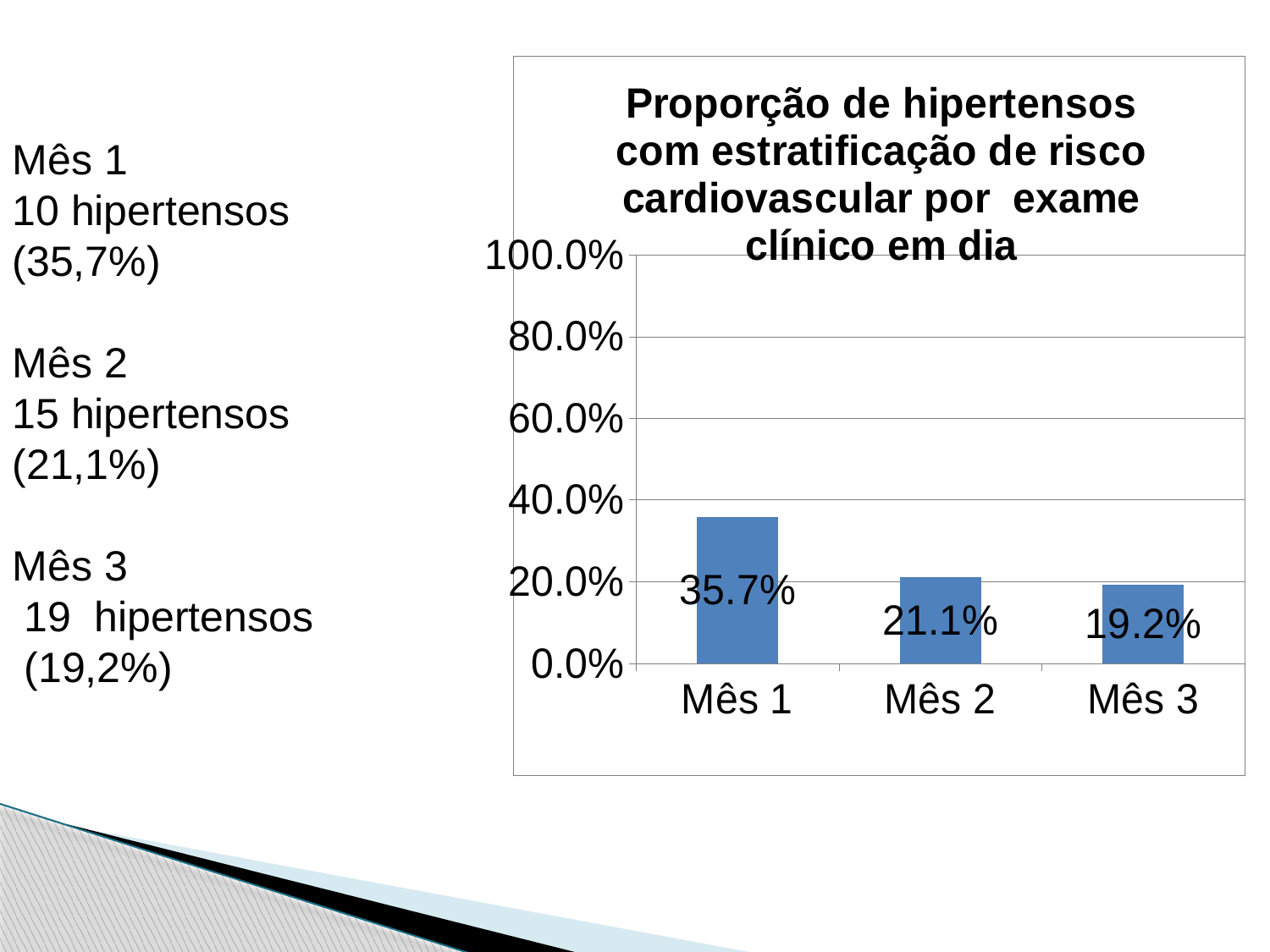
Which month has the highest value? Mês 1 What is the difference between the values for Mês 2 and Mês 3? 1.9% How many categories are shown on the x axis? 3 What is the value for Mês 2? 21.1% What is the difference between the values for Mês 1 and Mês 2? 14.6% Which month has the lowest value? Mês 3 Is the value for Mês 1 greater or less than 40.0%? less What is the value for Mês 3? 19.2% Do the values rise or fall from Mês 1 to Mês 3? fall Which is larger, the value for Mês 1 or the value for Mês 3? Mês 1 What is the value for Mês 1? 35.7% What kind of chart is shown? bar chart